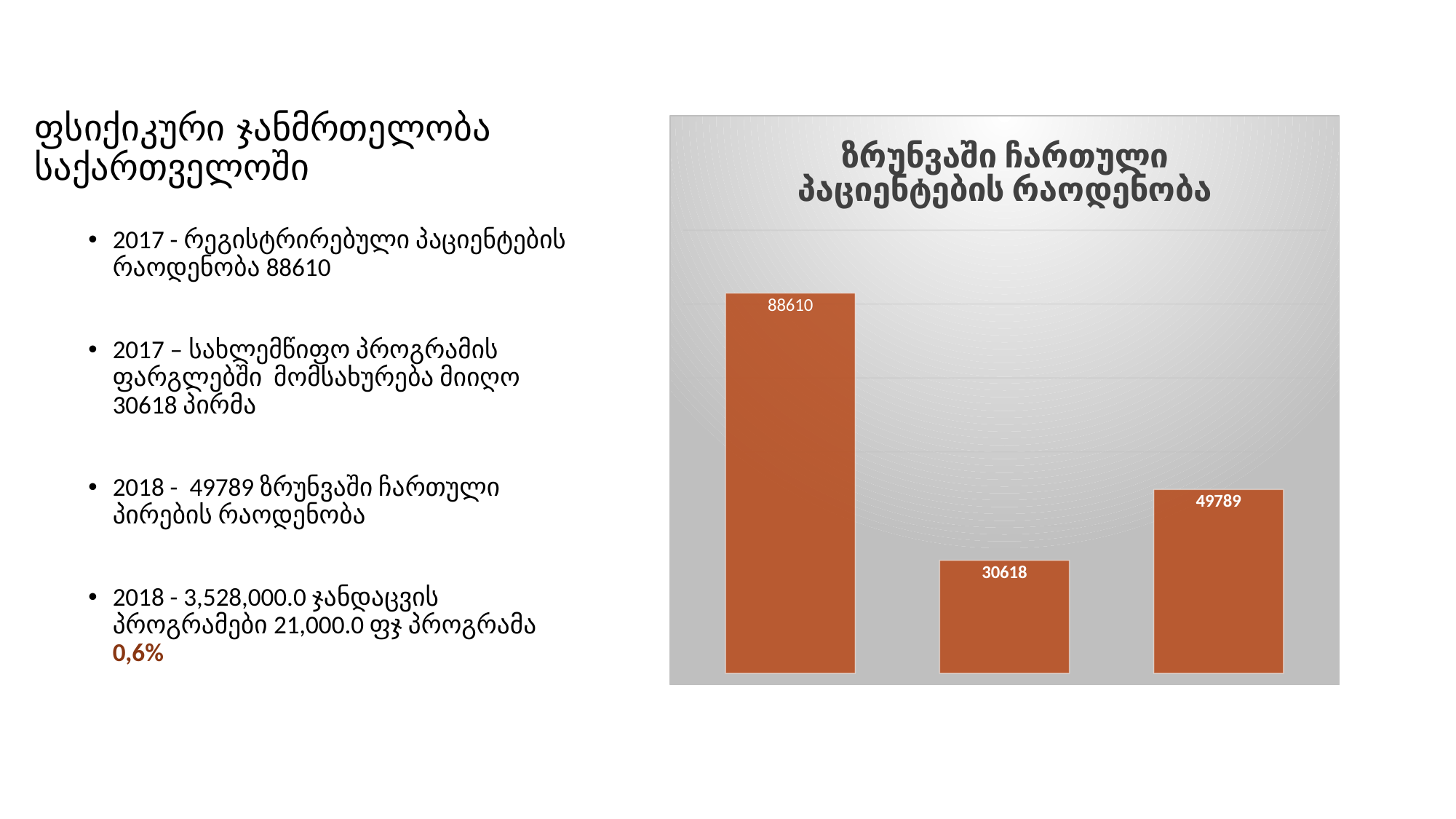
What is the value shown on the leftmost bar of the chart? 88610 How many bars does the chart show? 3 What is the value shown on the rightmost bar of the chart? 49789 Which bar has the lowest value in the chart? the middle bar (30618) What is the title of the chart? ზრუნვაში ჩართული პაციენტების რაოდენობა What type of chart is shown on the slide? bar chart Which bar has the highest value in the chart? the leftmost bar (88610) What is the difference between the rightmost bar (49789) and the middle bar (30618)? 19171 What colour are the bars in the chart? orange-brown What is the difference between the leftmost bar (88610) and the middle bar (30618)? 57992 What is the value shown on the middle bar of the chart? 30618 Which is larger: the value of the middle bar or the value of the rightmost bar? the rightmost bar (49789)